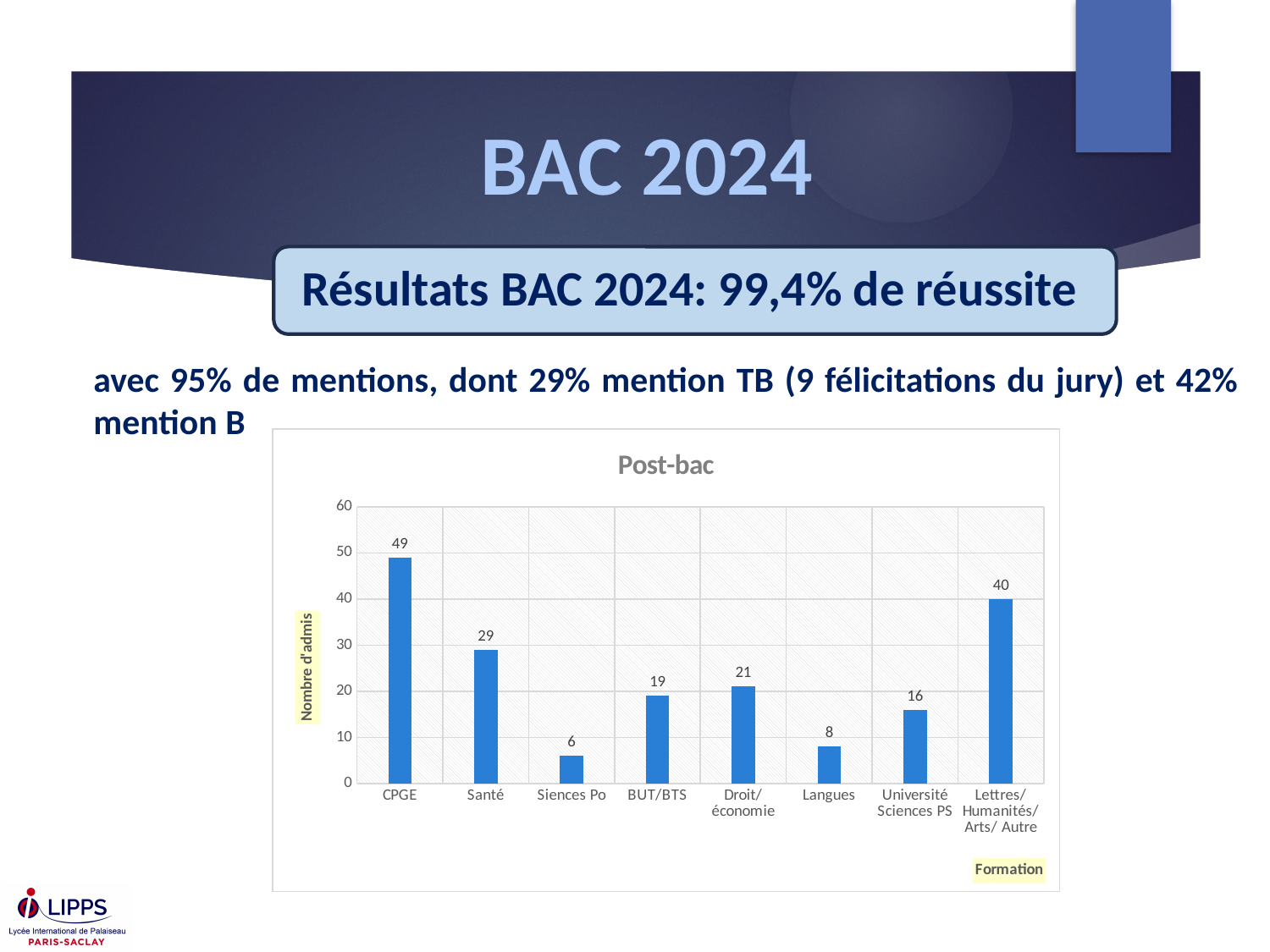
What is the value for CPGE in the Post-bac chart? 49 Which category has the highest value in the Post-bac chart? CPGE Is the value for Langues greater or less than 10? less What is the value for Santé in the Post-bac chart? 29 What is the value for Université Sciences PS in the Post-bac chart? 16 How many categories are shown on the x axis of the Post-bac chart? 8 What is the title of the chart on the slide? Post-bac Which is larger, the value for BUT/BTS or the value for Droit/ économie? Droit/ économie What is the label of the vertical axis of the Post-bac chart? Nombre d'admis Which category has the lowest value in the Post-bac chart? Siences Po What is the difference between the values for CPGE and Lettres/ Humanités/ Arts/ Autre? 9 What kind of chart is the Post-bac chart? bar chart